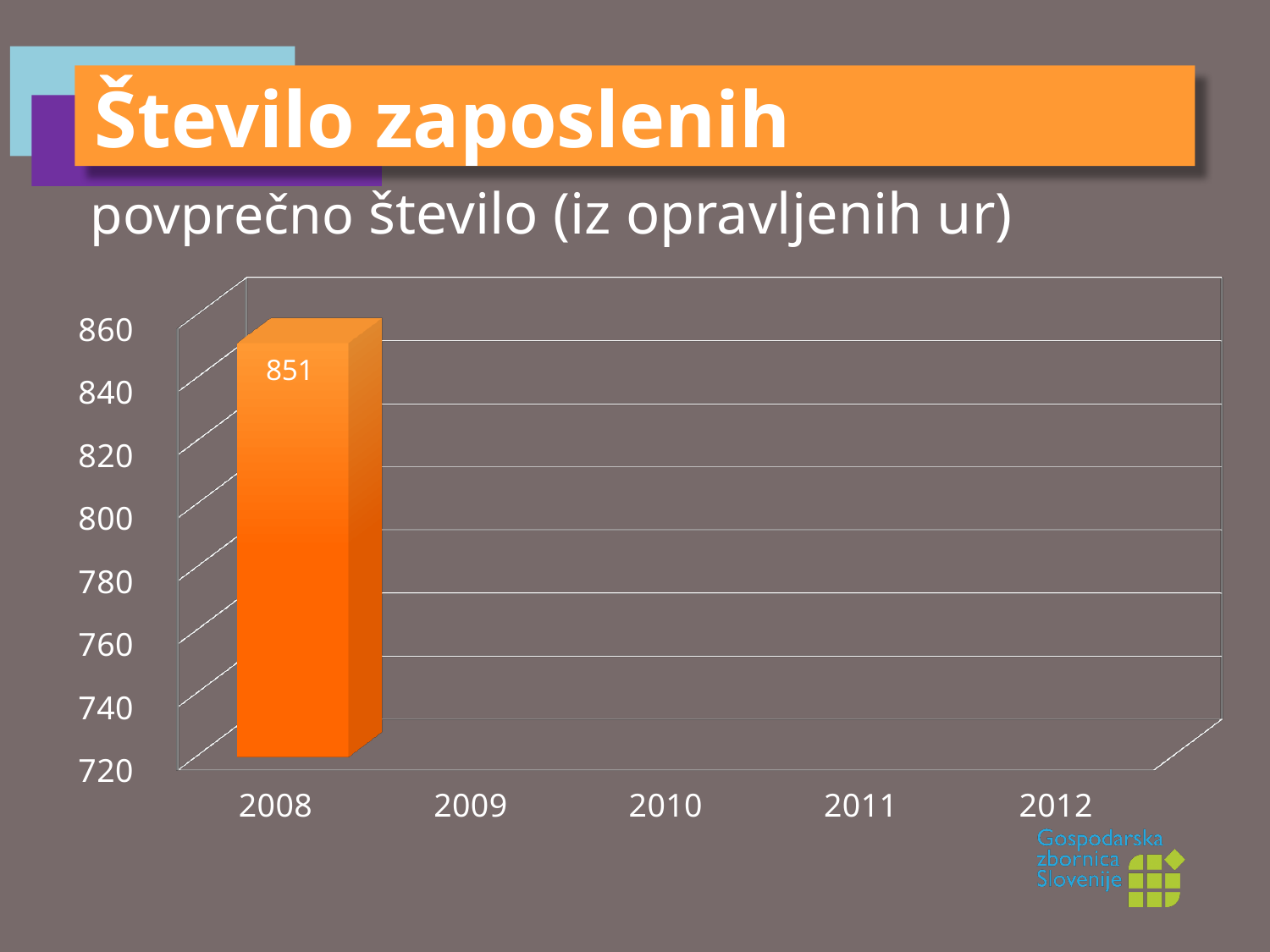
What is the first year labelled on the x axis? 2008 Which year has a bar plotted on the chart? 2008 Is the value for 2008 greater or less than 840? greater How many bars are plotted on the chart? 1 What kind of chart is shown on the slide? bar chart What is the highest value shown on the y axis? 860 What is the value for 2008? 851 What is the lowest value shown on the y axis? 720 What is the subtitle shown above the chart? povprečno število (iz opravljenih ur) How many years are labelled on the x axis? 5 What is the title of the slide? Število zaposlenih Is the value for 2008 greater or less than 860? less